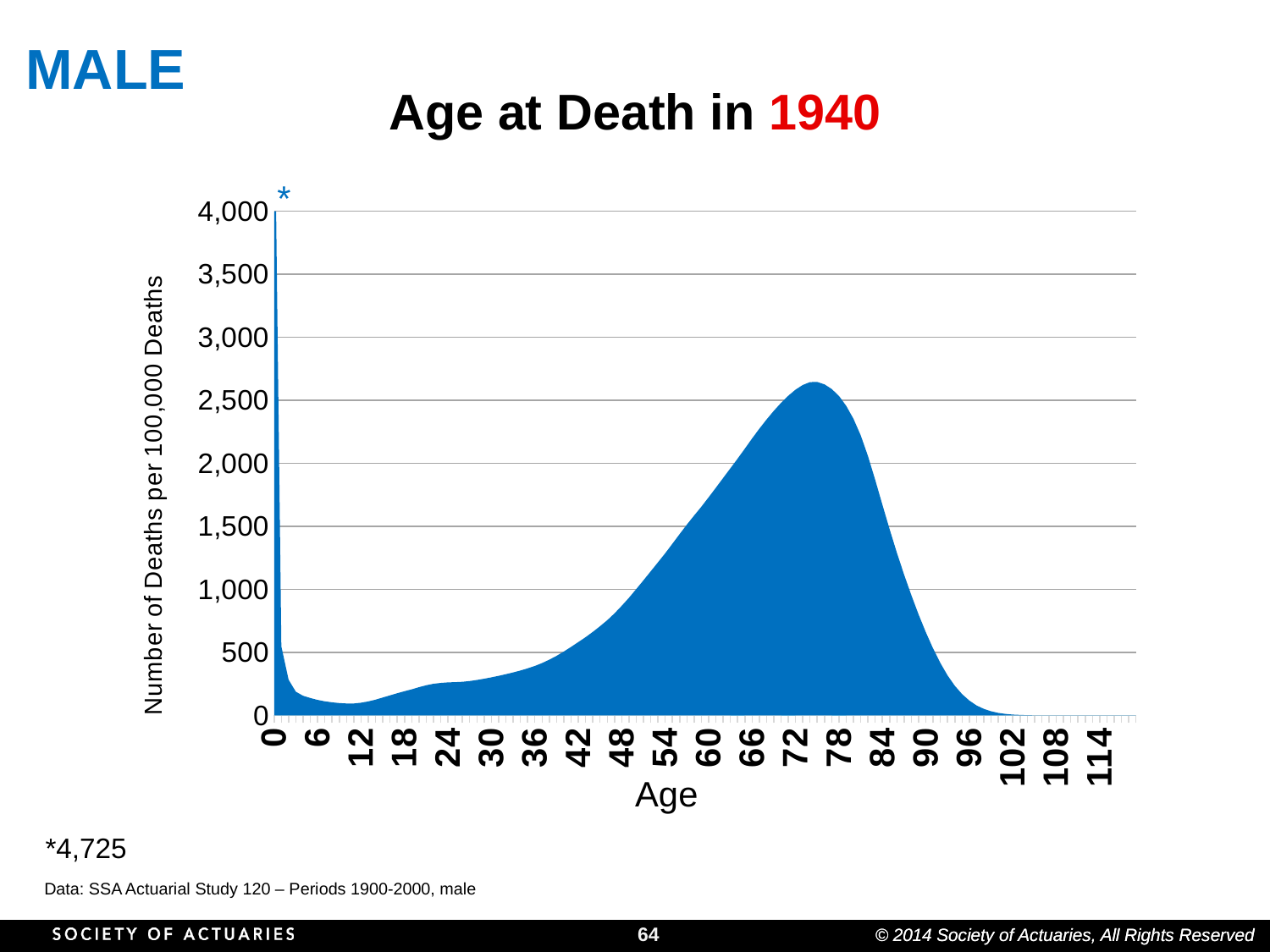
Is the value at age 48 greater or less than 1,000? less Which age has the larger number of deaths per 100,000 deaths, 72 or 48? 72 What is the number of deaths per 100,000 deaths at age 0, as given by the asterisk footnote? 4,725 What is the title of the chart? Age at Death in 1940 Is the value at age 102 greater or less than 500? less Between age 78 and age 96, do the values rise or fall? fall What kind of chart is shown on the slide? area chart Between age 42 and age 72, do the values rise or fall? rise Is the value at age 90 greater or less than 1,000? less At which age is the number of deaths per 100,000 deaths highest? 0 What is the label of the vertical axis? Number of Deaths per 100,000 Deaths